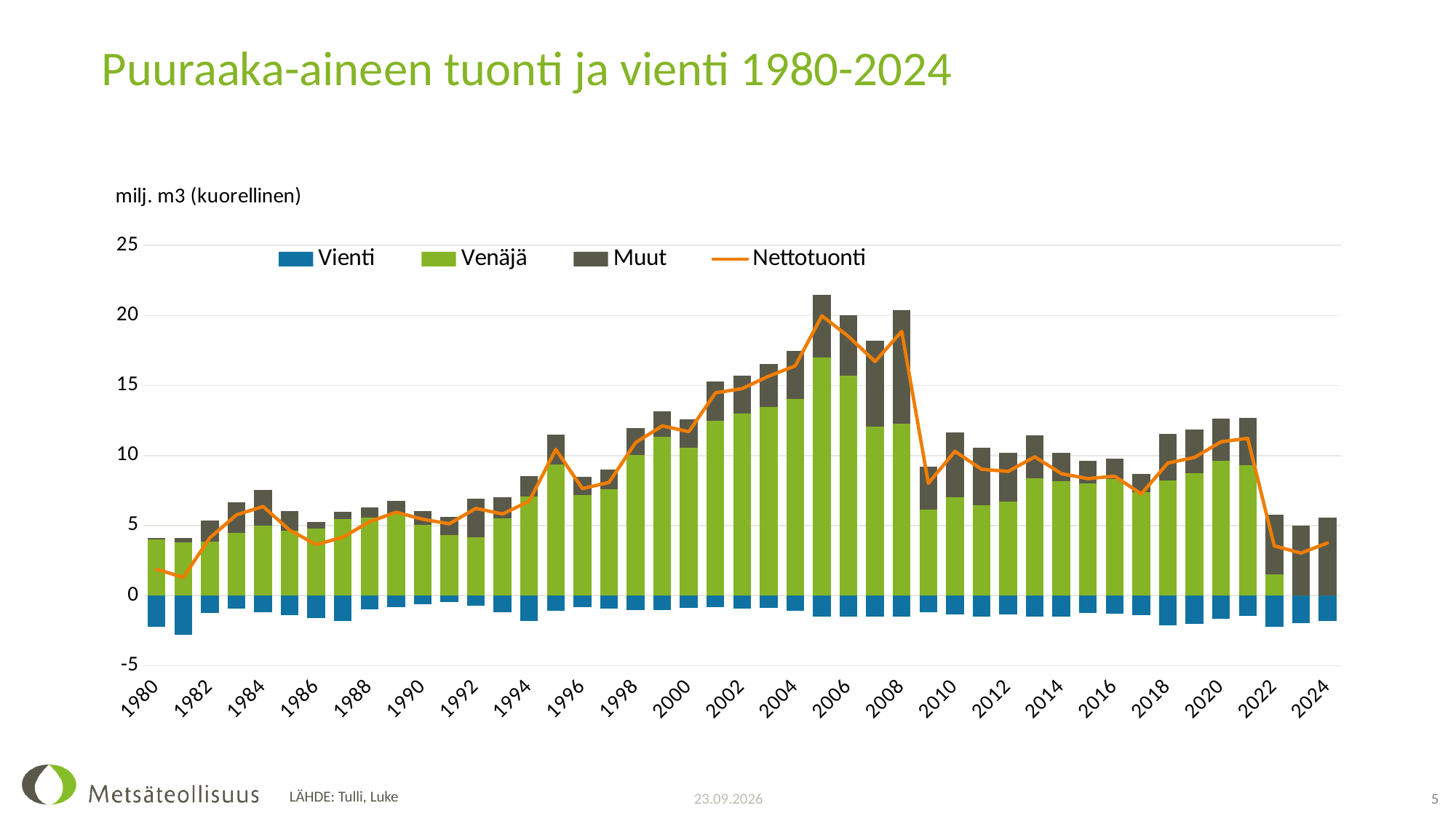
Is the Venäjä value for 2005 greater or less than 15? greater What unit is shown on the y axis of the chart? milj. m3 (kuorellinen) Is the Nettotuonti value for 2005 greater or less than 15? greater What are the series listed in the legend? Vienti, Venäjä, Muut, Nettotuonti Is the Nettotuonti value for 2023 greater or less than 5? less In which year is the Nettotuonti line at its lowest value? 1981 Which year has the larger Nettotuonti value, 2005 or 2009? 2005 How many series does the legend list? 4 In which year is the Vienti bar the most negative? 1981 What kind of chart is shown on the slide? Stacked bar chart with a line In which year does the Nettotuonti line reach its highest value? 2005 Does the Nettotuonti line rise or fall between 2005 and 2009? fall